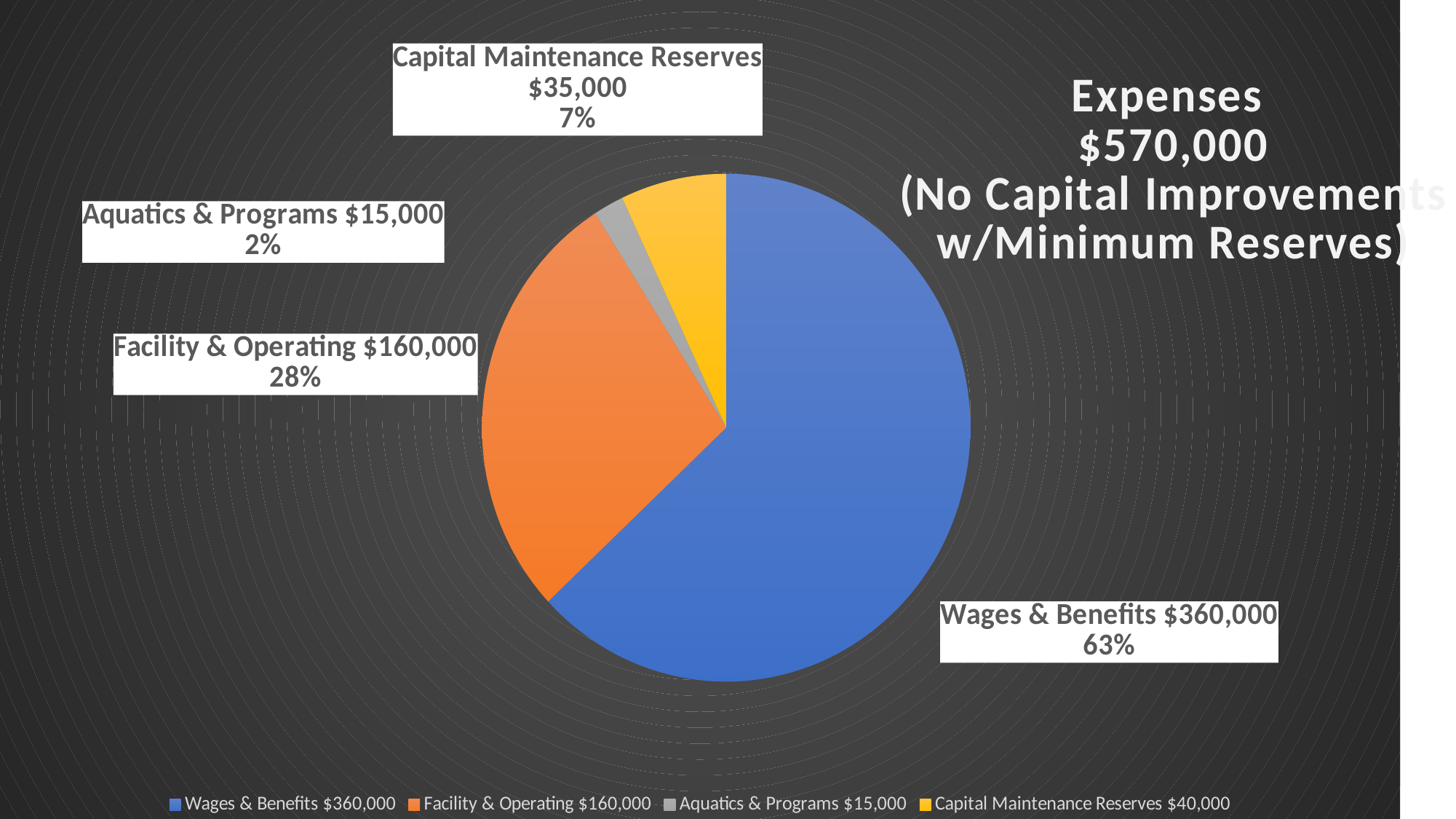
Which category has the largest slice of the pie? Wages & Benefits What is the difference in percentage points between Wages & Benefits and Facility & Operating? 35 percentage points What percentage of expenses is Aquatics & Programs? 2% What is the dollar amount shown for Wages & Benefits? $360,000 What is the title of the chart? Expenses $570,000 (No Capital Improvements w/Minimum Reserves) What percentage of expenses is Wages & Benefits? 63% How many categories does the pie chart show? 4 Which category has the smallest slice of the pie? Aquatics & Programs What percentage of expenses is Capital Maintenance Reserves? 7% What type of chart is shown on the slide? pie chart What is the dollar amount shown for Facility & Operating? $160,000